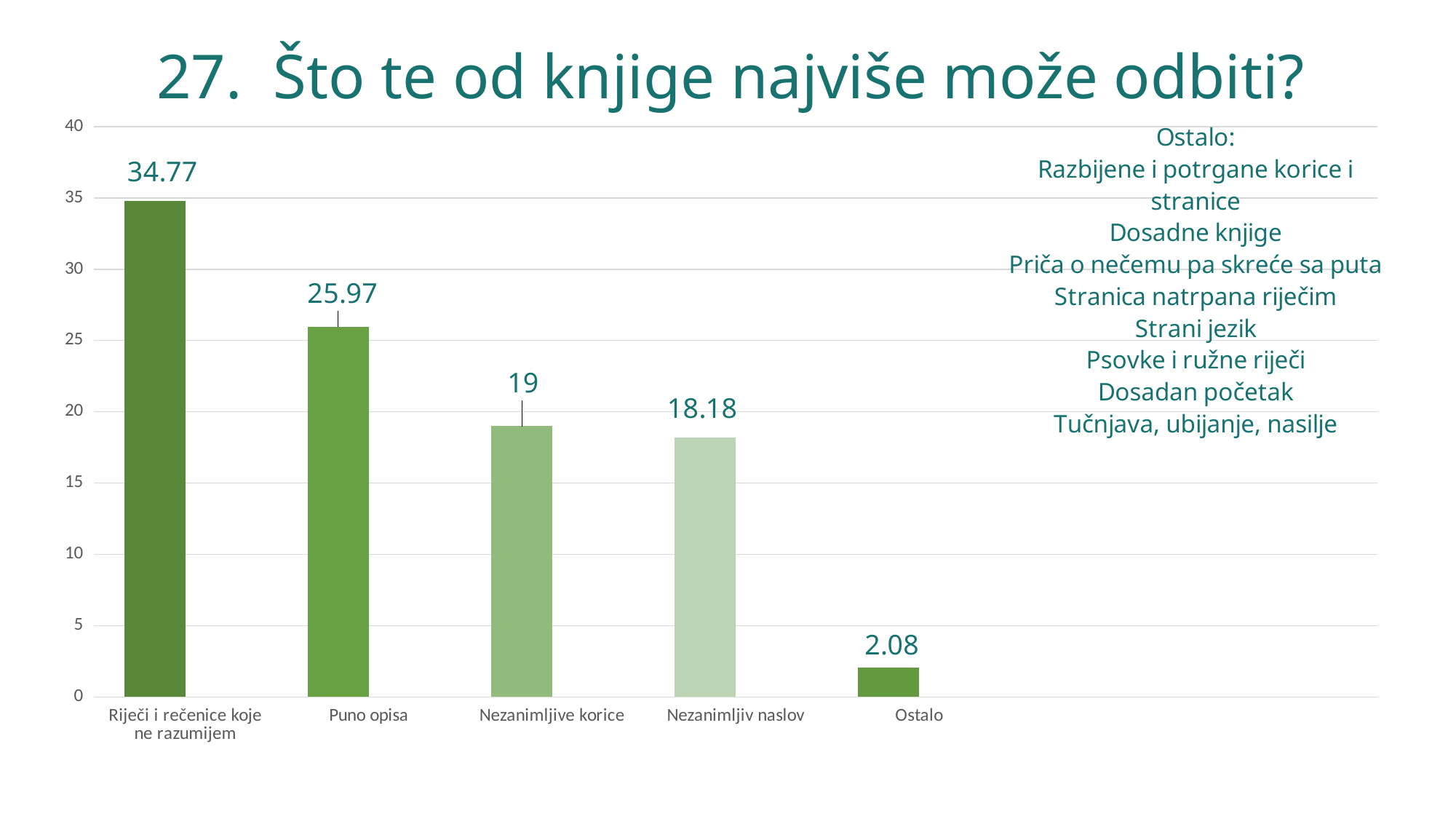
Which category has the lowest value? Ostalo What kind of chart is shown on the slide? bar chart Is the value for "Nezanimljive korice" greater or less than 20? less What is the value for "Ostalo"? 2.08 How many categories are shown in the chart? 5 Which is larger, the value for "Puno opisa" or the value for "Nezanimljive korice"? Puno opisa What is the difference between the values for "Riječi i rečenice koje ne razumijem" and "Puno opisa"? 8.8 What is the difference between the values for "Nezanimljive korice" and "Nezanimljiv naslov"? 0.82 What is the value for "Nezanimljiv naslov"? 18.18 What is the value for "Puno opisa"? 25.97 What is the title of the slide? 27. Što te od knjige najviše može odbiti? Which category has the highest value? Riječi i rečenice koje ne razumijem